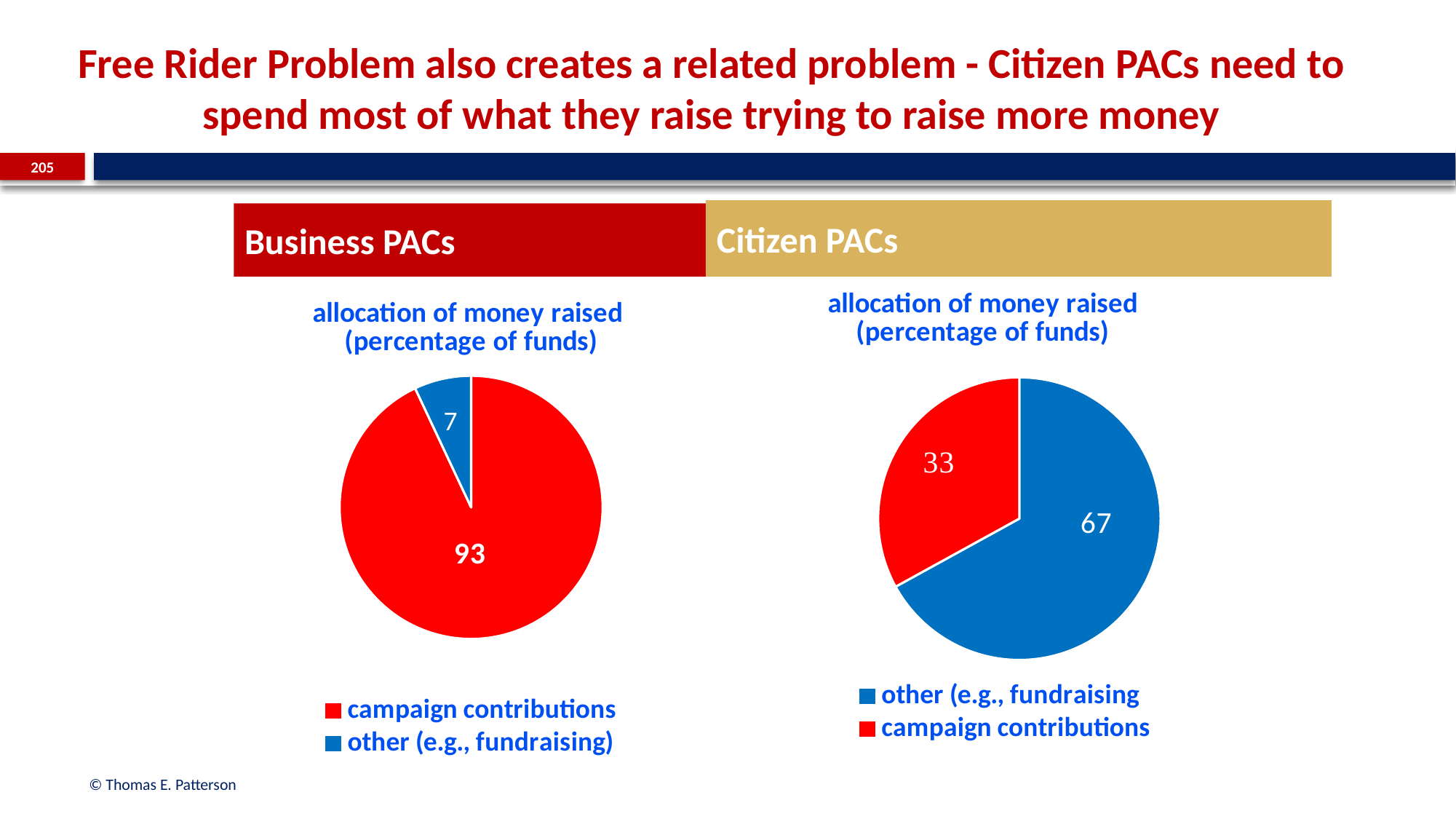
In the Citizen PACs pie chart, which slice is the smallest? campaign contributions In the Citizen PACs pie chart, what is the value for other (e.g., fundraising)? 67 In the Business PACs pie chart, which slice is the largest? campaign contributions In the Business PACs pie chart, what is the value for campaign contributions? 93 In the Business PACs pie chart, what is the value for other (e.g., fundraising)? 7 Which is larger: campaign contributions for Business PACs or campaign contributions for Citizen PACs? Business PACs In the Citizen PACs pie chart, what is the difference between the other (e.g., fundraising) value and the campaign contributions value? 34 In the Citizen PACs pie chart, what is the value for campaign contributions? 33 What type of chart is used for the Business PACs allocation of money raised? Pie chart How many slices does the Citizen PACs pie chart have? 2 In the Citizen PACs pie chart, what colour is the other (e.g., fundraising) slice? Blue How many entries does the legend of the Business PACs pie chart list? 2